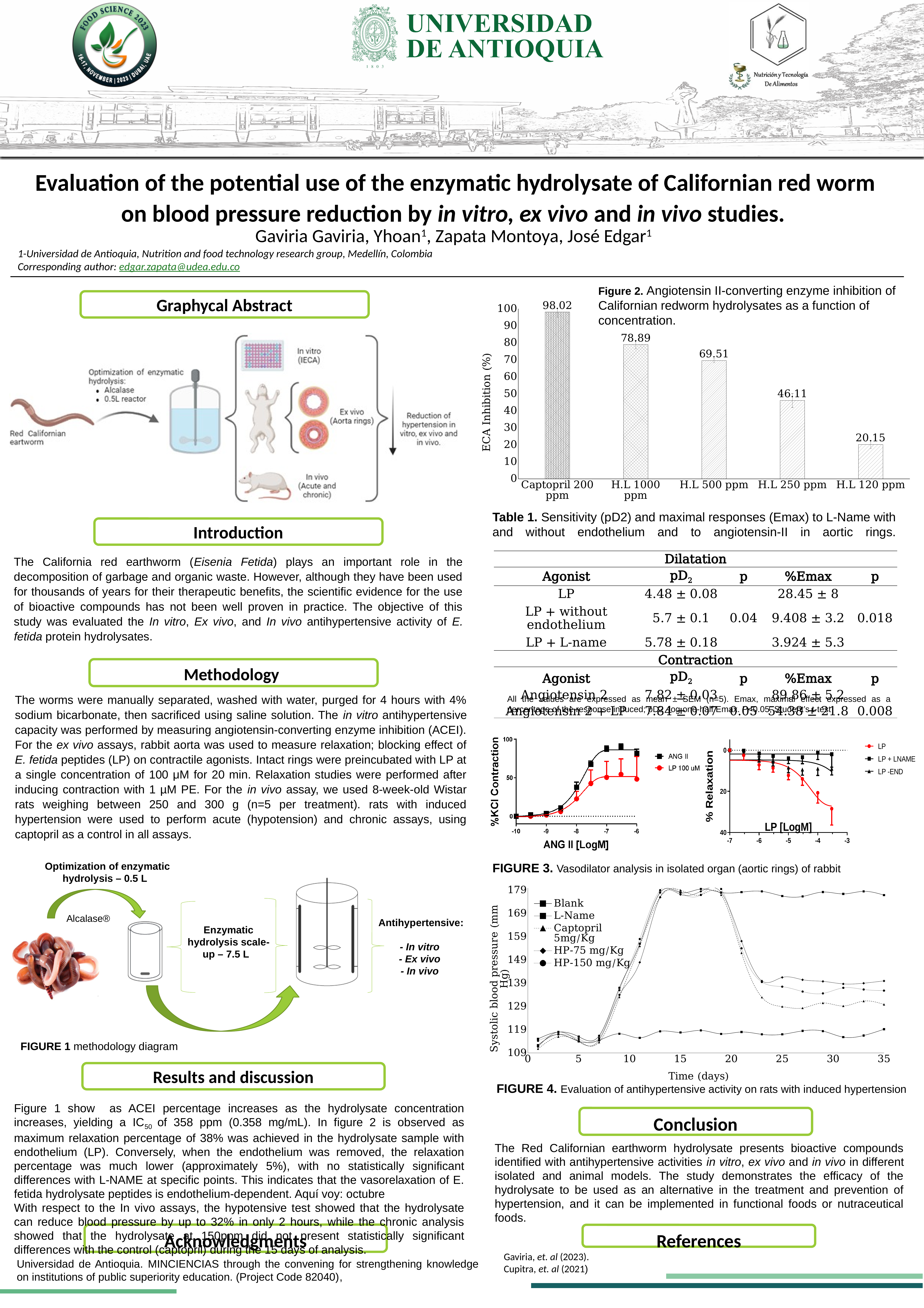
What kind of chart is Figure 2? Bar chart In the Figure 2 bar chart, what is the ECA inhibition value for Captopril 200 ppm? 98.02 How many series does the legend of the right-hand chart in Figure 3 (% Relaxation vs LP [LogM]) list? 3 How many categories are shown in the Figure 2 bar chart? 5 In the Figure 4 chart, is the systolic blood pressure of the Blank group at day 35 greater or less than 129? less In the Figure 2 bar chart, which has a higher ECA inhibition, H.L 250 ppm or H.L 500 ppm? H.L 500 ppm In the Figure 2 bar chart, what is the difference in ECA inhibition between H.L 1000 ppm and H.L 250 ppm? 32.78 In the Figure 2 bar chart, which category has the highest ECA inhibition? Captopril 200 ppm How many series does the legend of the Figure 4 chart (systolic blood pressure vs time) list? 5 In the Figure 2 bar chart, do the ECA inhibition values rise or fall as the hydrolysate concentration decreases from H.L 1000 ppm to H.L 120 ppm? Fall In the Figure 2 bar chart, which category has the lowest ECA inhibition? H.L 120 ppm In the Figure 2 bar chart, what is the ECA inhibition value for H.L 500 ppm? 69.51